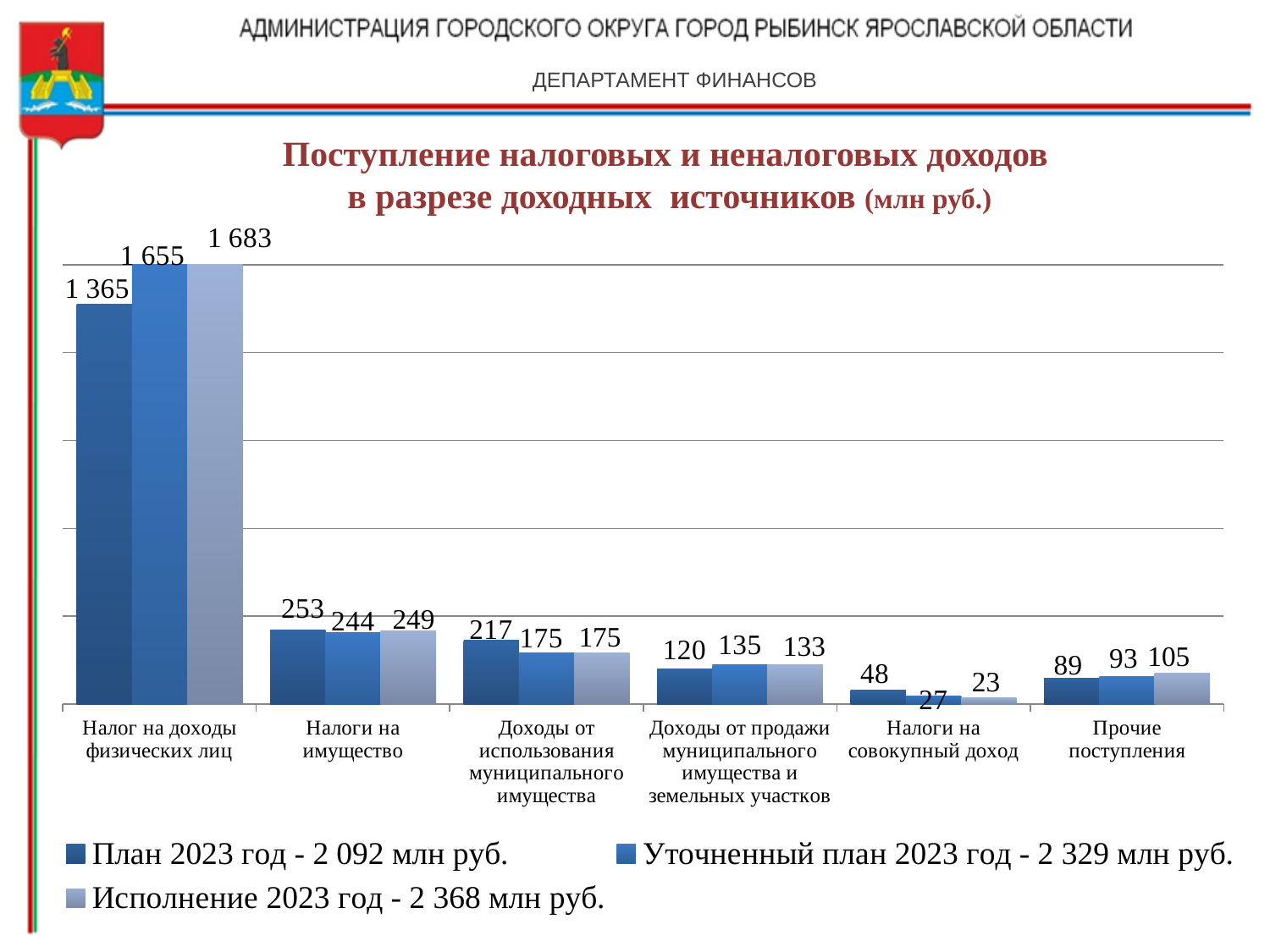
Which category has the lowest "План 2023 год" value? Налоги на совокупный доход What is the value of "Исполнение 2023 год" for "Прочие поступления"? 105 What is the difference between "Исполнение 2023 год" and "План 2023 год" for "Налог на доходы физических лиц"? 318 How many series does the legend list? 3 For "Доходы от продажи муниципального имущества и земельных участков", which is larger: "Уточненный план 2023 год" or "Исполнение 2023 год"? Уточненный план 2023 год Which category has the highest "Исполнение 2023 год" value? Налог на доходы физических лиц What is the difference between "План 2023 год" and "Уточненный план 2023 год" for "Доходы от использования муниципального имущества"? 42 What kind of chart is shown on the slide? Bar chart What is the value of "Уточненный план 2023 год" for "Налоги на совокупный доход"? 27 What is the value of "План 2023 год" for "Налоги на имущество"? 253 How many categories are shown on the x axis? 6 What is the value of "Исполнение 2023 год" for "Налог на доходы физических лиц"? 1 683